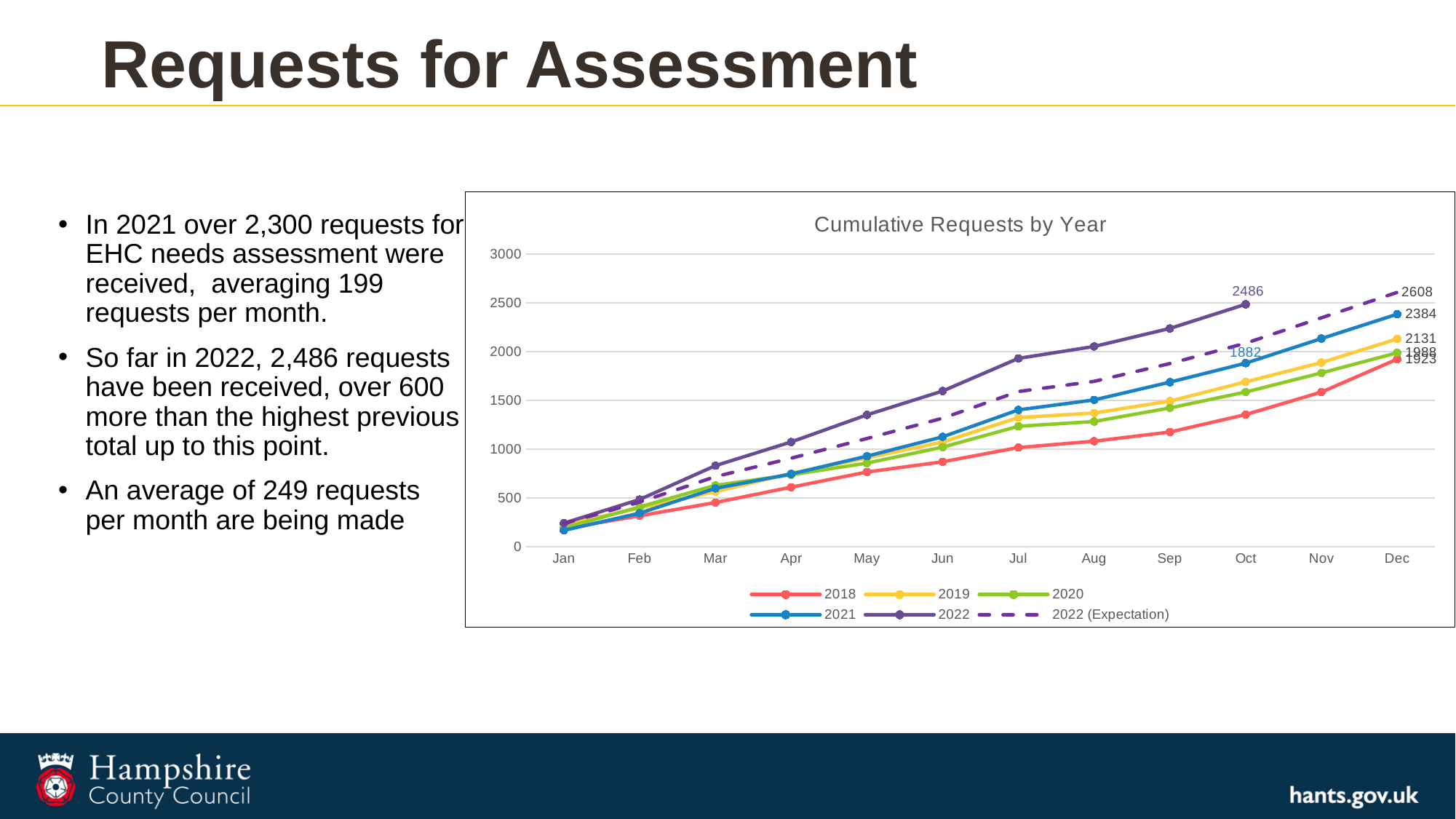
What is the cumulative value for 2021 in Oct? 1882 Which is larger in Dec: the 2021 value or the 2019 value? 2021 What is the title of the chart? Cumulative Requests by Year What is the value for 2022 (Expectation) in Dec? 2608 What is the cumulative value for 2021 in Dec? 2384 What is the cumulative value for 2019 in Dec? 2131 How many series does the legend of the chart list? 6 What is the cumulative value for 2022 in Oct? 2486 What is the difference between the 2022 value and the 2021 value in Oct? 604 What kind of chart is shown on the slide? line chart How many months are shown along the x axis of the chart? 12 Is the value for 2022 in Jul greater or less than 1500? greater